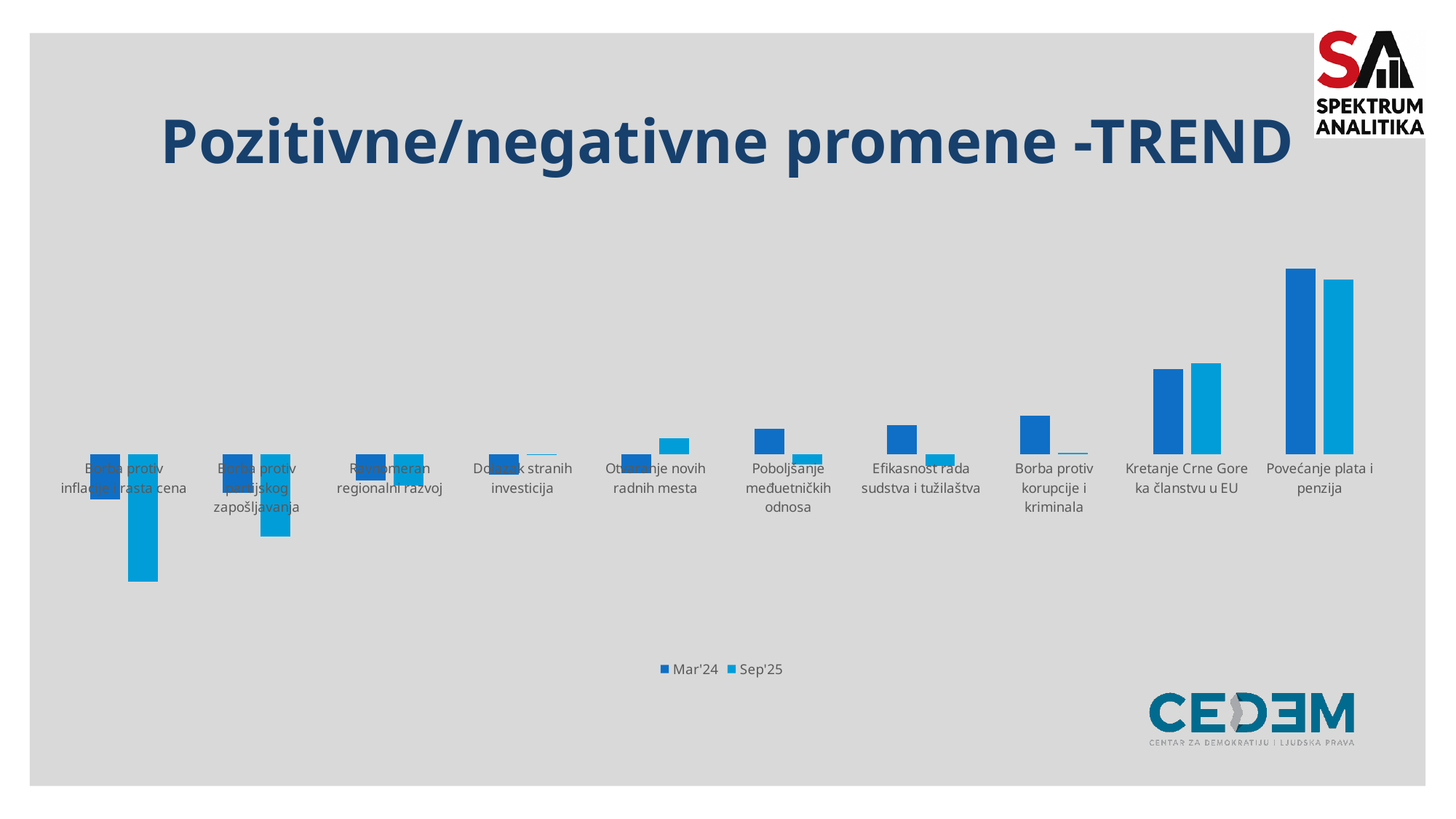
Do the Mar'24 values generally rise or fall moving from left to right along the x axis? Rise For Otvaranje novih radnih mesta, which series has the larger value, Mar'24 or Sep'25? Sep'25 Which category has the highest value for the Mar'24 series? Povećanje plata i penzija What kind of chart is shown on the slide? Bar chart Which category has the lowest value for the Sep'25 series? Borba protiv inflacije i rasta cena What is the title of the chart slide? Pozitivne/negativne promene -TREND For Borba protiv korupcije i kriminala, which series has the larger value, Mar'24 or Sep'25? Mar'24 How many categories are shown on the x axis of the chart? 10 What are the two series named in the legend? Mar'24 and Sep'25 Which category has the highest value for the Sep'25 series? Povećanje plata i penzija For Poboljšanje međuetničkih odnosa, which series has the larger value, Mar'24 or Sep'25? Mar'24 How many series does the chart's legend list? 2